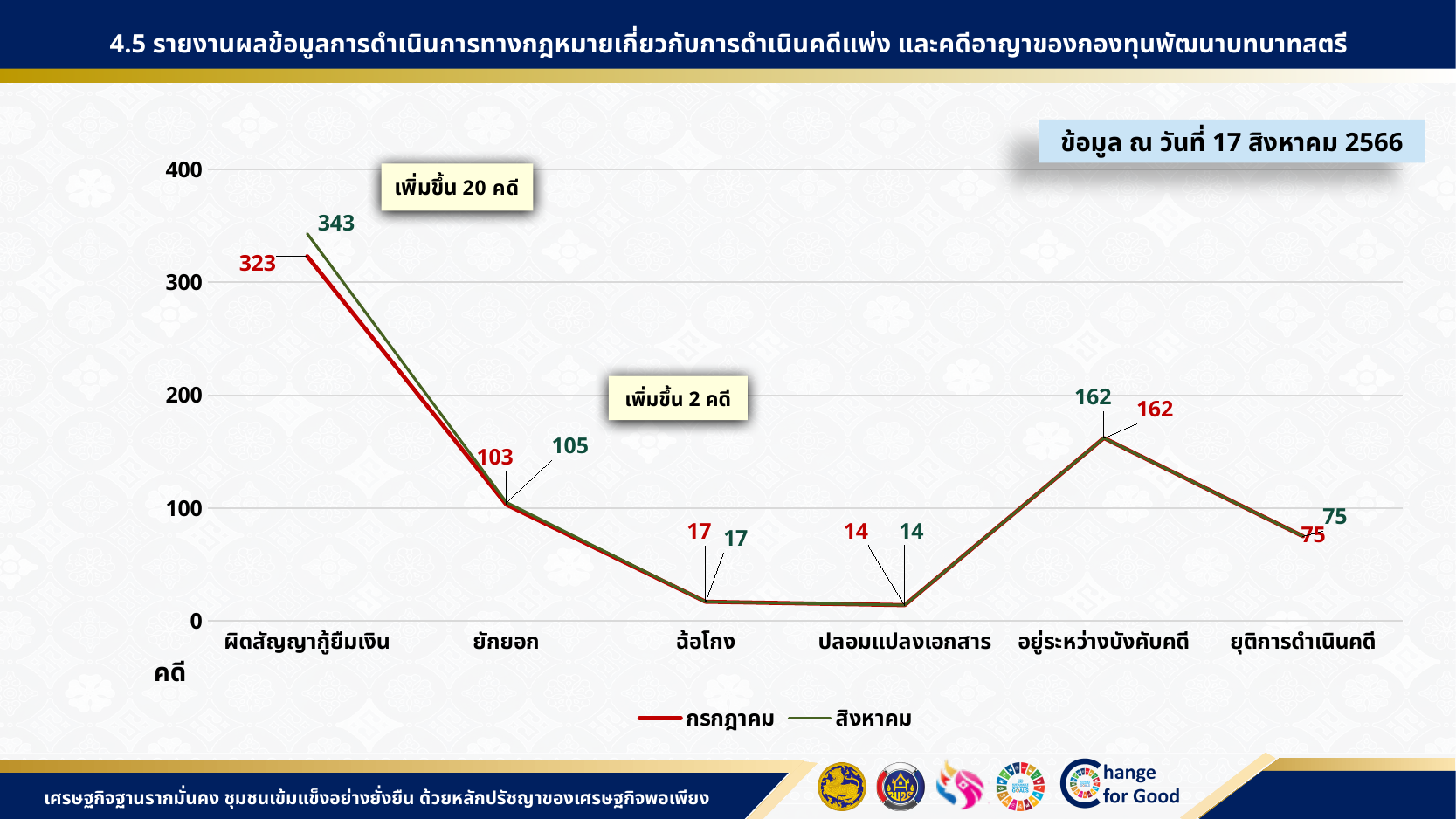
How many categories are shown on the x axis? 6 Which is larger for ยักยอก: the กรกฎาคม value or the สิงหาคม value? สิงหาคม What is the value for ผิดสัญญากู้ยืมเงิน in the สิงหาคม series? 343 What is the value for ผิดสัญญากู้ยืมเงิน in the กรกฎาคม series? 323 What type of chart is shown on the slide? line chart How many series does the legend list? 2 Which category has the lowest value in the กรกฎาคม series? ปลอมแปลงเอกสาร What is the value for ปลอมแปลงเอกสาร in the กรกฎาคม series? 14 Which series is drawn in red in the legend? กรกฎาคม What is the difference between the สิงหาคม and กรกฎาคม values for ผิดสัญญากู้ยืมเงิน? 20 What is the value for ยักยอก in the สิงหาคม series? 105 Which category has the highest value in the สิงหาคม series? ผิดสัญญากู้ยืมเงิน